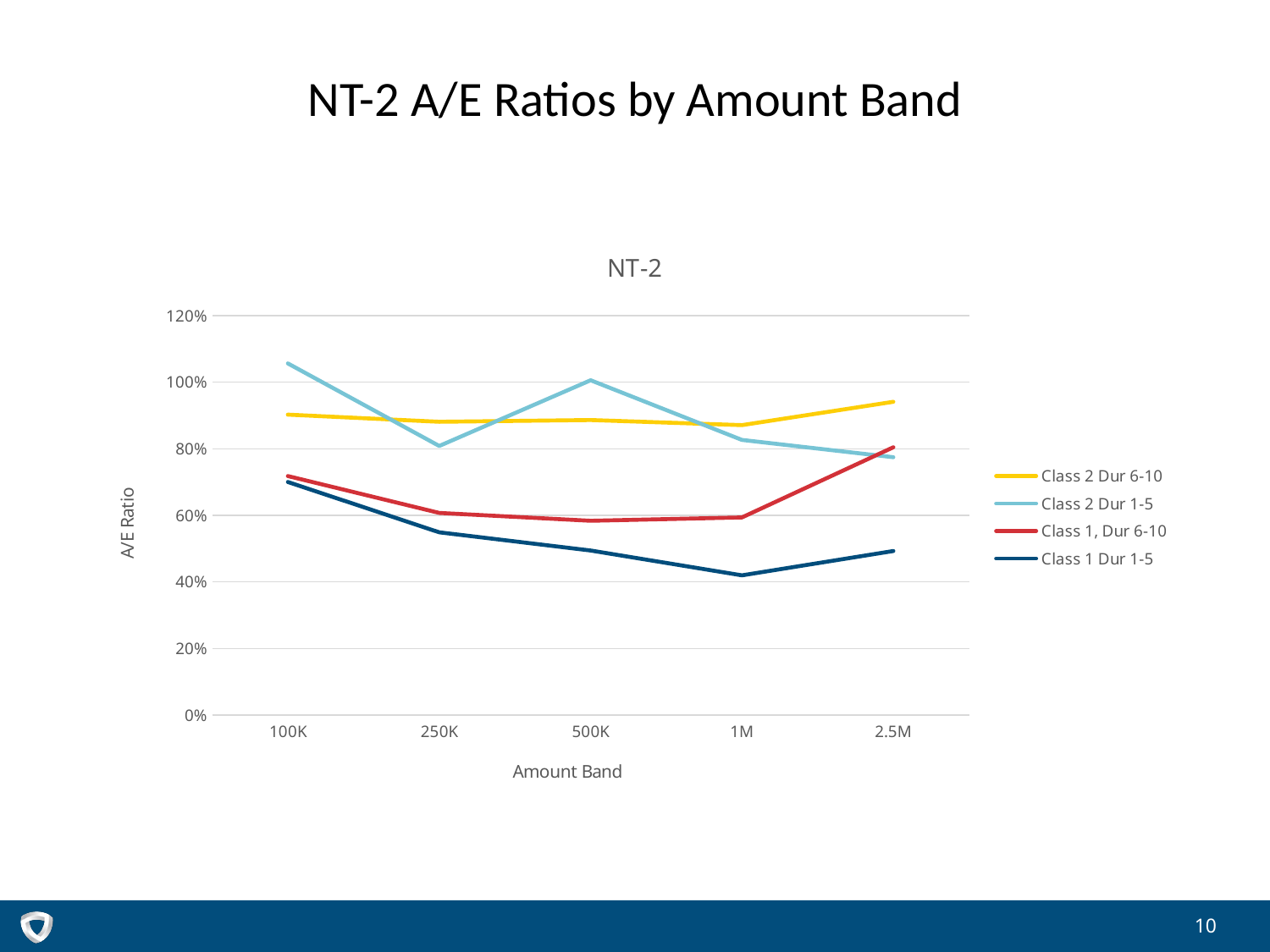
At which amount band is the Class 1 Dur 1-5 series at its lowest? 1M Is the value for Class 2 Dur 1-5 at 100K greater or less than 100%? greater Does the Class 1 Dur 1-5 series rise or fall from 100K to 1M? Fall Which series has the lowest value at the 500K amount band? Class 1 Dur 1-5 How many amount bands are shown on the x axis? 5 At 2.5M, which is larger: Class 2 Dur 6-10 or Class 2 Dur 1-5? Class 2 Dur 6-10 Is the value for Class 1, Dur 6-10 at 2.5M greater or less than 60%? greater What type of chart is shown on the slide? Line chart What is the title of the vertical axis? A/E Ratio Which series has the highest value at the 100K amount band? Class 2 Dur 1-5 Is the value for Class 1 Dur 1-5 at 1M greater or less than 60%? less How many series does the legend list? 4